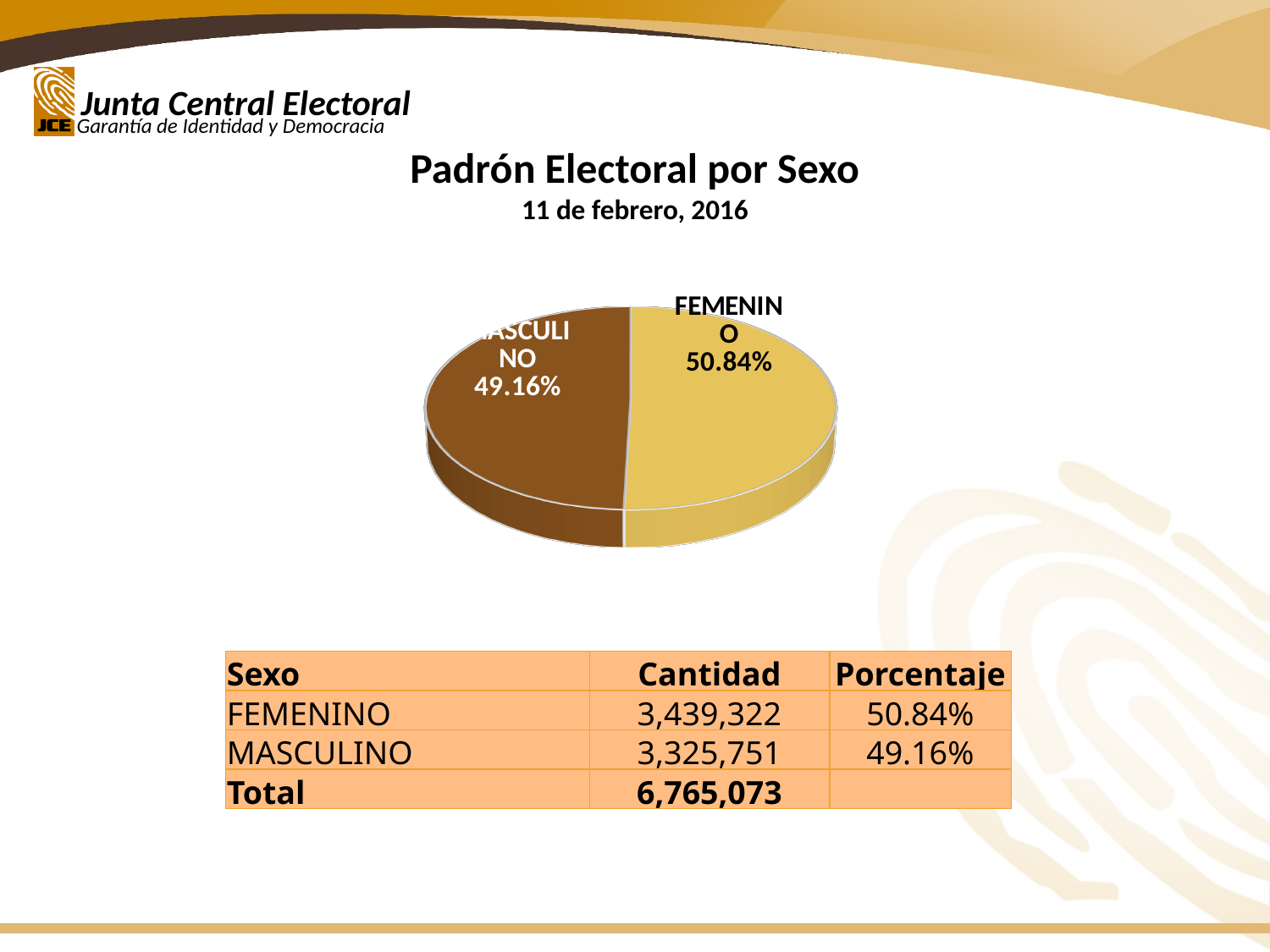
How many slices does the pie chart have? 2 What percentage does the MASCULINO slice of the pie chart show? 49.16% What is the difference in percentage points between the FEMENINO and MASCULINO slices? 1.68% What share of the pie does the MASCULINO slice represent? 49.16% What is the title of the chart on the slide? Padrón Electoral por Sexo What percentage does the FEMENINO slice of the pie chart show? 50.84% Which is larger in the pie chart, FEMENINO or MASCULINO? FEMENINO What date is shown under the chart title? 11 de febrero, 2016 Which slice of the pie chart is the smallest? MASCULINO What kind of chart is shown on the slide? pie chart Is the FEMENINO slice greater or less than 50% of the pie? greater Which slice of the pie chart is the largest? FEMENINO